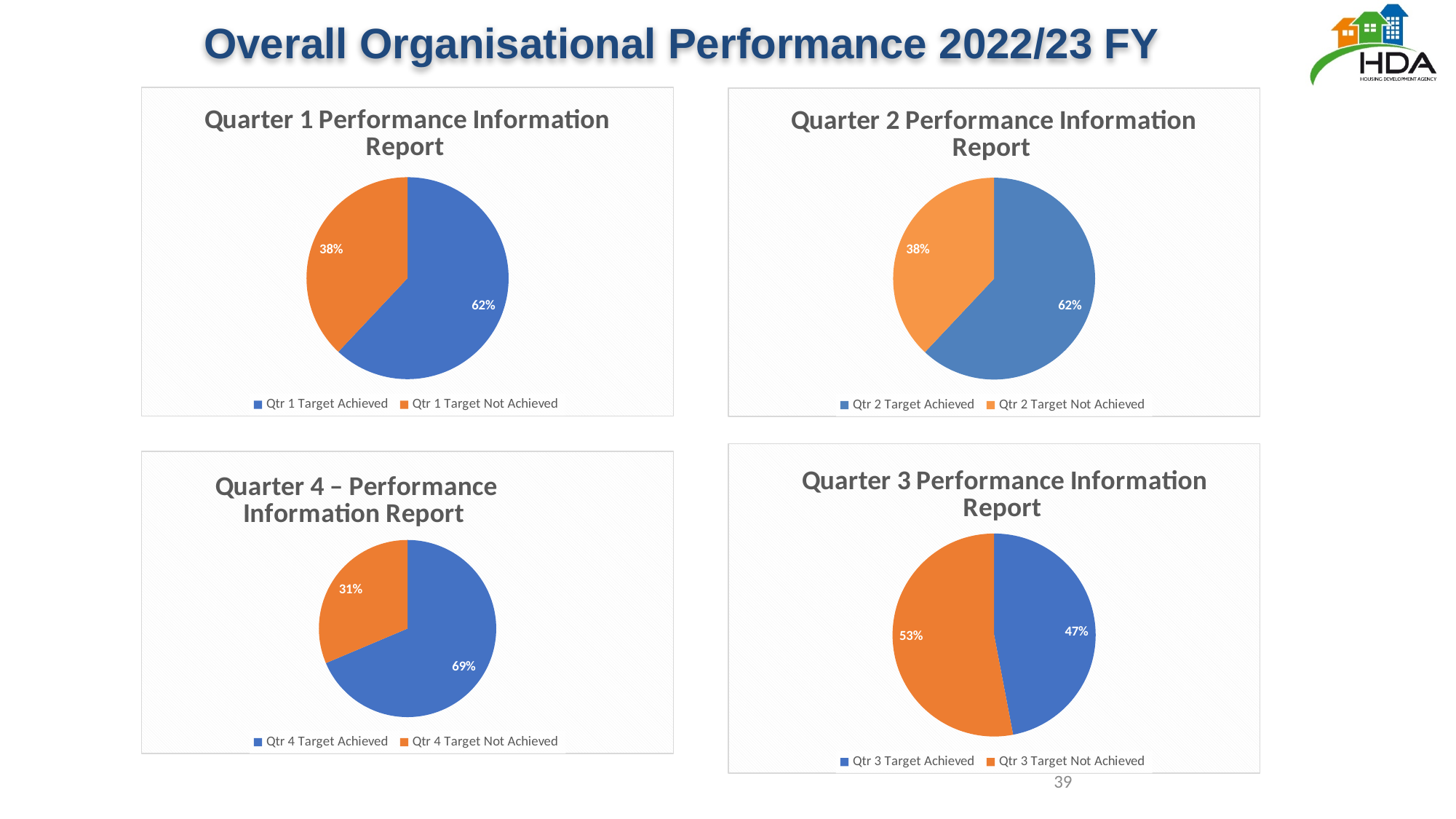
In the Quarter 4 Performance Information Report chart, what is the difference between Qtr 4 Target Achieved and Qtr 4 Target Not Achieved? 38% In the Quarter 1 Performance Information Report chart, what is the value for Qtr 1 Target Not Achieved? 38% In the Quarter 3 Performance Information Report chart, what is the value for Qtr 3 Target Not Achieved? 53% What kind of chart is the Quarter 2 Performance Information Report chart? Pie chart In the Quarter 3 Performance Information Report chart, which slice is larger, Qtr 3 Target Achieved or Qtr 3 Target Not Achieved? Qtr 3 Target Not Achieved In the Quarter 4 Performance Information Report chart, which slice is the largest? Qtr 4 Target Achieved How many entries does the legend of the Quarter 1 Performance Information Report chart list? 2 In the Quarter 1 Performance Information Report chart, what share of the pie is Qtr 1 Target Achieved? 62% How many slices does the Quarter 4 Performance Information Report pie chart have? 2 In the Quarter 4 Performance Information Report chart, what is the value for Qtr 4 Target Achieved? 69% In the Quarter 2 Performance Information Report chart, what is the value for Qtr 2 Target Achieved? 62% In the Quarter 3 Performance Information Report chart, what is the difference between Qtr 3 Target Not Achieved and Qtr 3 Target Achieved? 6%